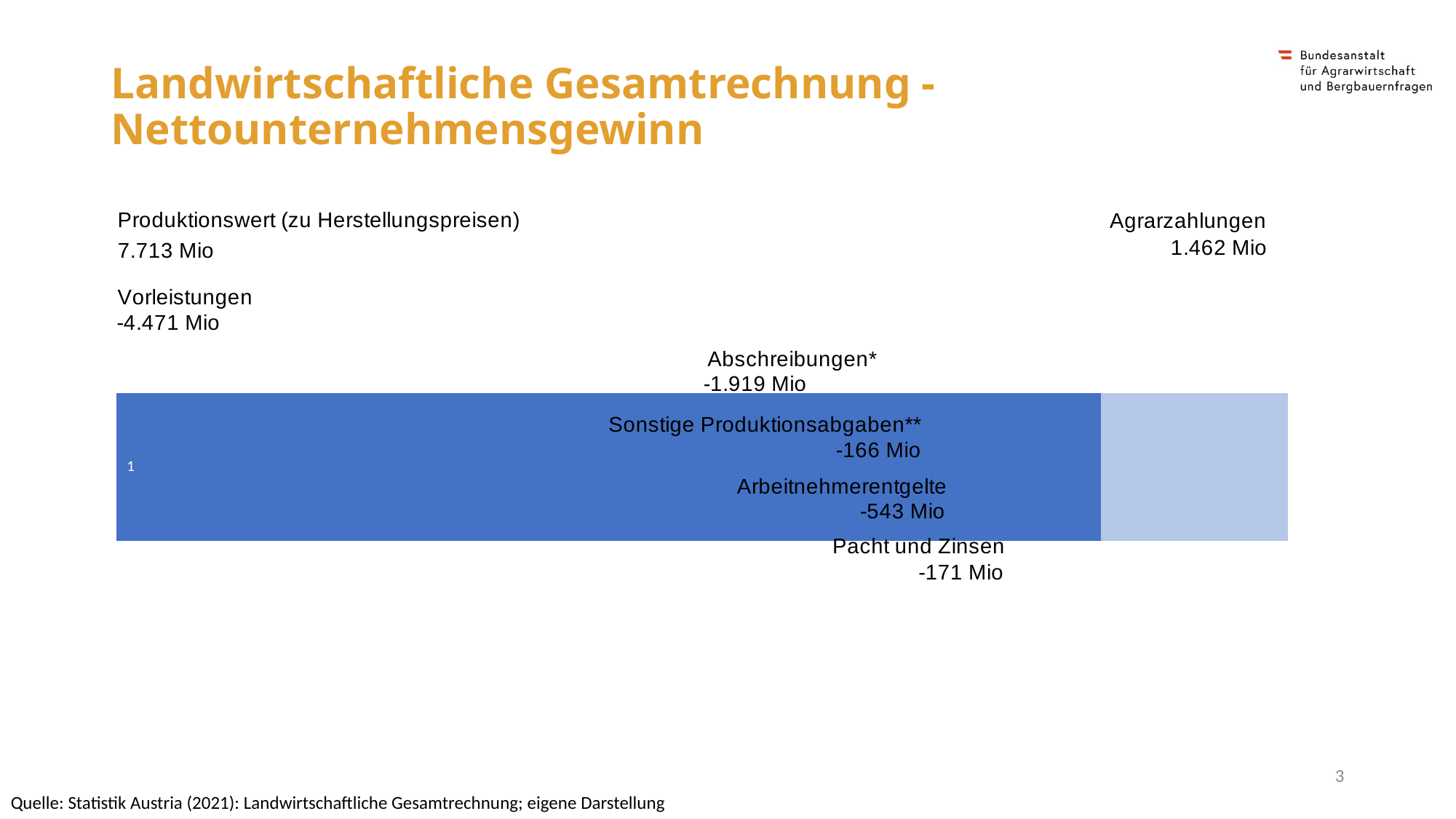
What is the value shown for Vorleistungen? -4.471 Mio Which of the negative items has the largest magnitude? Vorleistungen Which is larger, Produktionswert (zu Herstellungspreisen) or Agrarzahlungen? Produktionswert (zu Herstellungspreisen) How many segments does the stacked bar have? 2 What is the value shown for Pacht und Zinsen? -171 Mio What is the value shown for Agrarzahlungen? 1.462 Mio What is the value shown for Abschreibungen*? -1.919 Mio What is the value shown for Produktionswert (zu Herstellungspreisen)? 7.713 Mio What is the value shown for Arbeitnehmerentgelte? -543 Mio What is the difference between Arbeitnehmerentgelte (-543 Mio) and Pacht und Zinsen (-171 Mio) in magnitude? 372 Mio Which of the negative items has the smallest magnitude? Sonstige Produktionsabgaben** What kind of chart is shown on the slide? bar chart